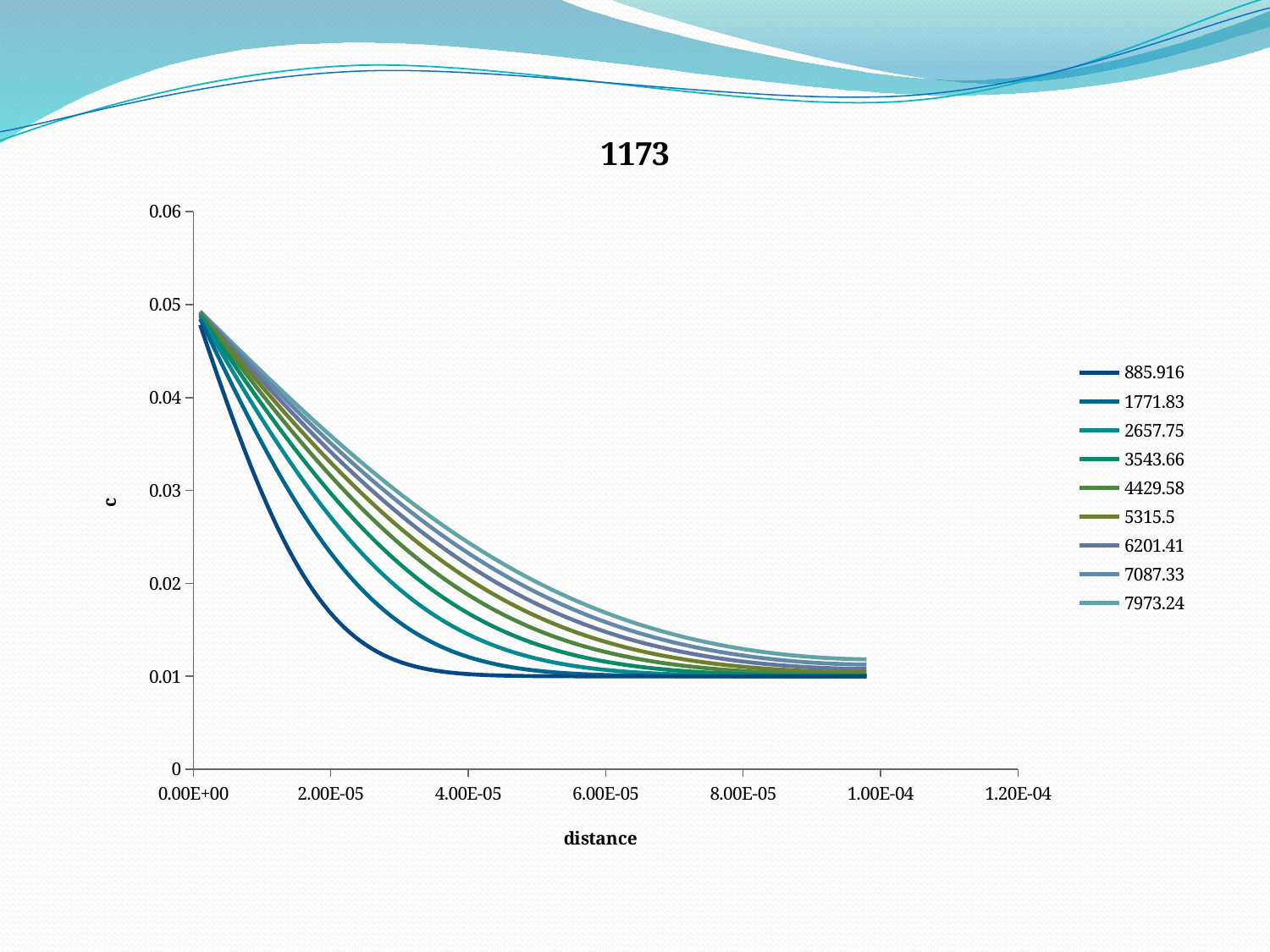
Which series has the highest value at a distance of 6.00E-05? 7973.24 Is the value for series 1771.83 at a distance of 6.00E-05 greater or less than 0.02? less How many series does the legend list? 9 Which series has the lowest value at a distance of 2.00E-05? 885.916 What is the label of the x axis? distance What kind of chart is shown on the slide? line chart Is the starting value of series 885.916 at distance 0.00E+00 greater or less than 0.06? less Is the value for series 7973.24 at a distance of 2.00E-05 greater or less than 0.03? greater What is the title of the chart? 1173 At a distance of 4.00E-05, which series has the larger value, 885.916 or 7973.24? 7973.24 Do the values of the series rise or fall as distance increases? fall